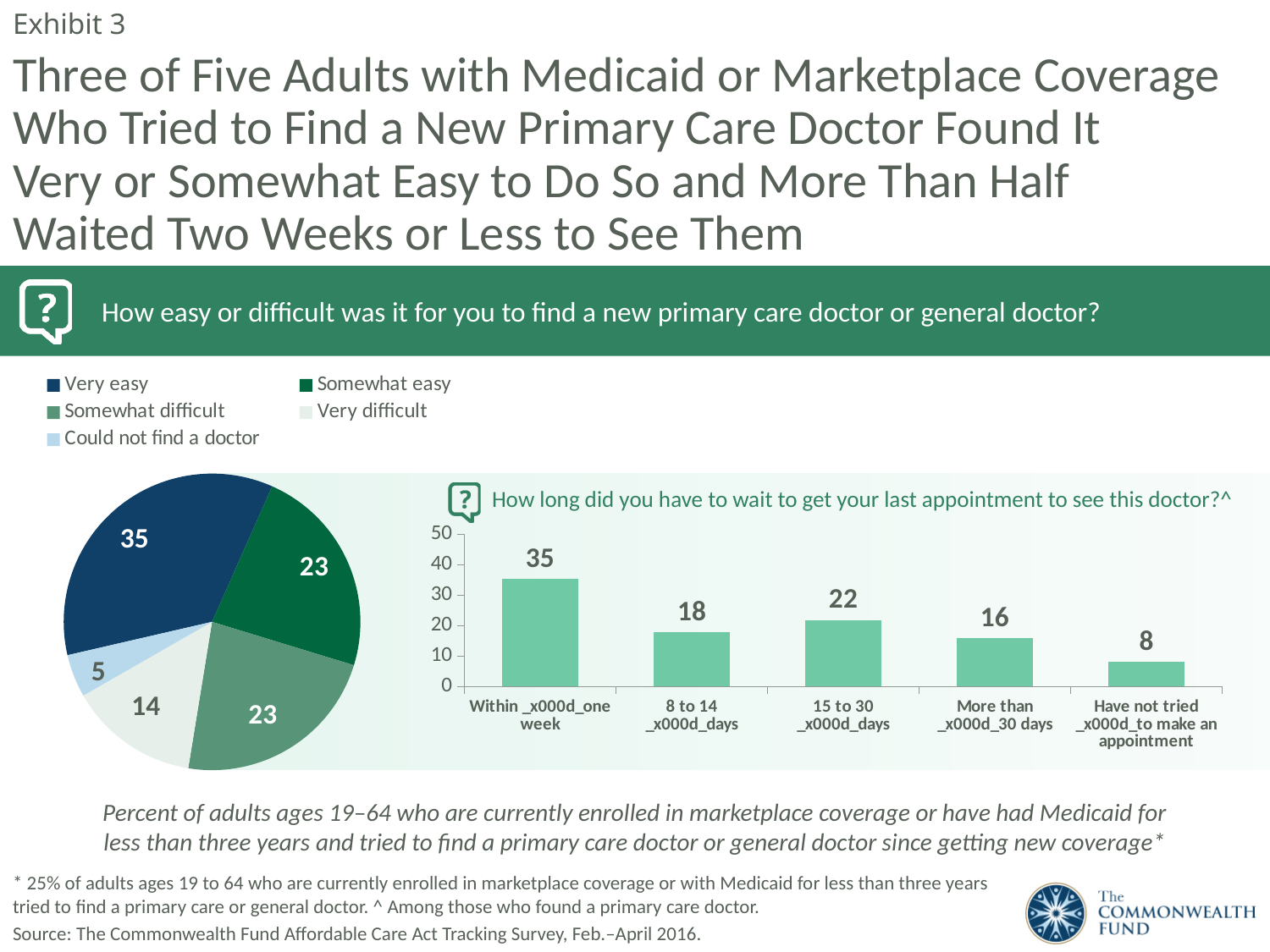
In the bar chart on the right, what value is shown for 'Within one week'? 35 In the pie chart on the left, what value is shown for 'Could not find a doctor'? 5 In the pie chart on the left, which response has the largest slice? Very easy In the bar chart on the right, which category has the lowest value? Have not tried to make an appointment What type of chart is the chart on the right of the slide? Bar chart In the pie chart on the left, how many entries does the legend list? 5 In the pie chart on the left, what is the difference between the 'Very easy' value and the 'Very difficult' value? 21 In the bar chart on the right, what value is shown for '15 to 30 days'? 22 In the bar chart on the right, which is larger: the value for '8 to 14 days' or the value for 'More than 30 days'? 8 to 14 days In the bar chart on the right, how many categories are shown on the x axis? 5 In the pie chart on the left, which response has the smallest slice? Could not find a doctor In the pie chart on the left, what percentage of adults said it was very easy to find a new primary care doctor? 35